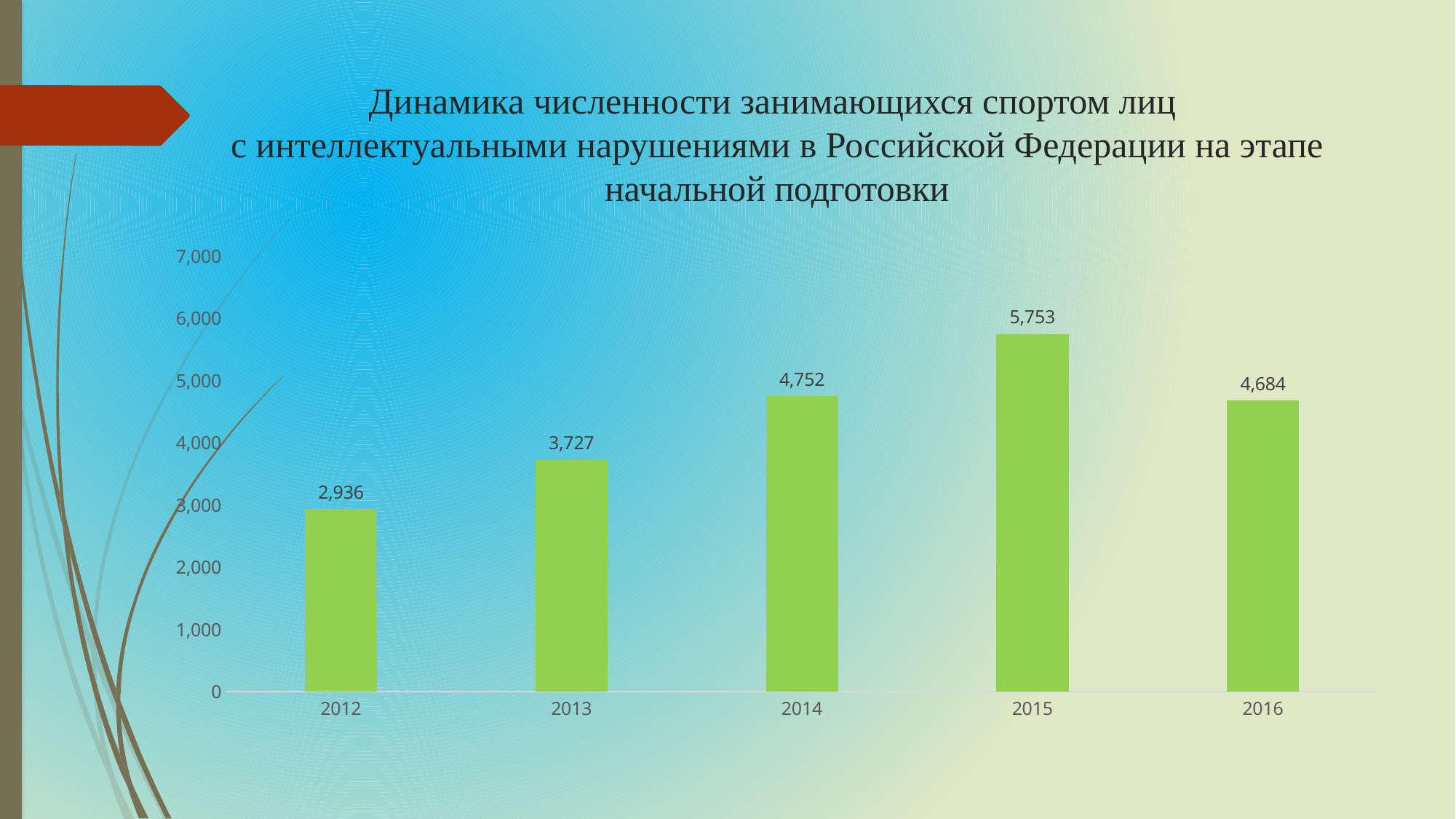
Do the values rise or fall from 2012 to 2015? rise What kind of chart is shown on the slide? bar chart How many years are shown on the x axis? 5 Which year has the highest value? 2015 What is the value for 2015? 5,753 What is the difference between the values for 2013 and 2012? 791 Which year has the lowest value? 2012 What is the value for 2012? 2,936 What is the value for 2016? 4,684 What is the difference between the values for 2015 and 2016? 1,069 Is the value for 2013 greater or less than 4,000? less Which is larger, the value for 2014 or the value for 2016? 2014